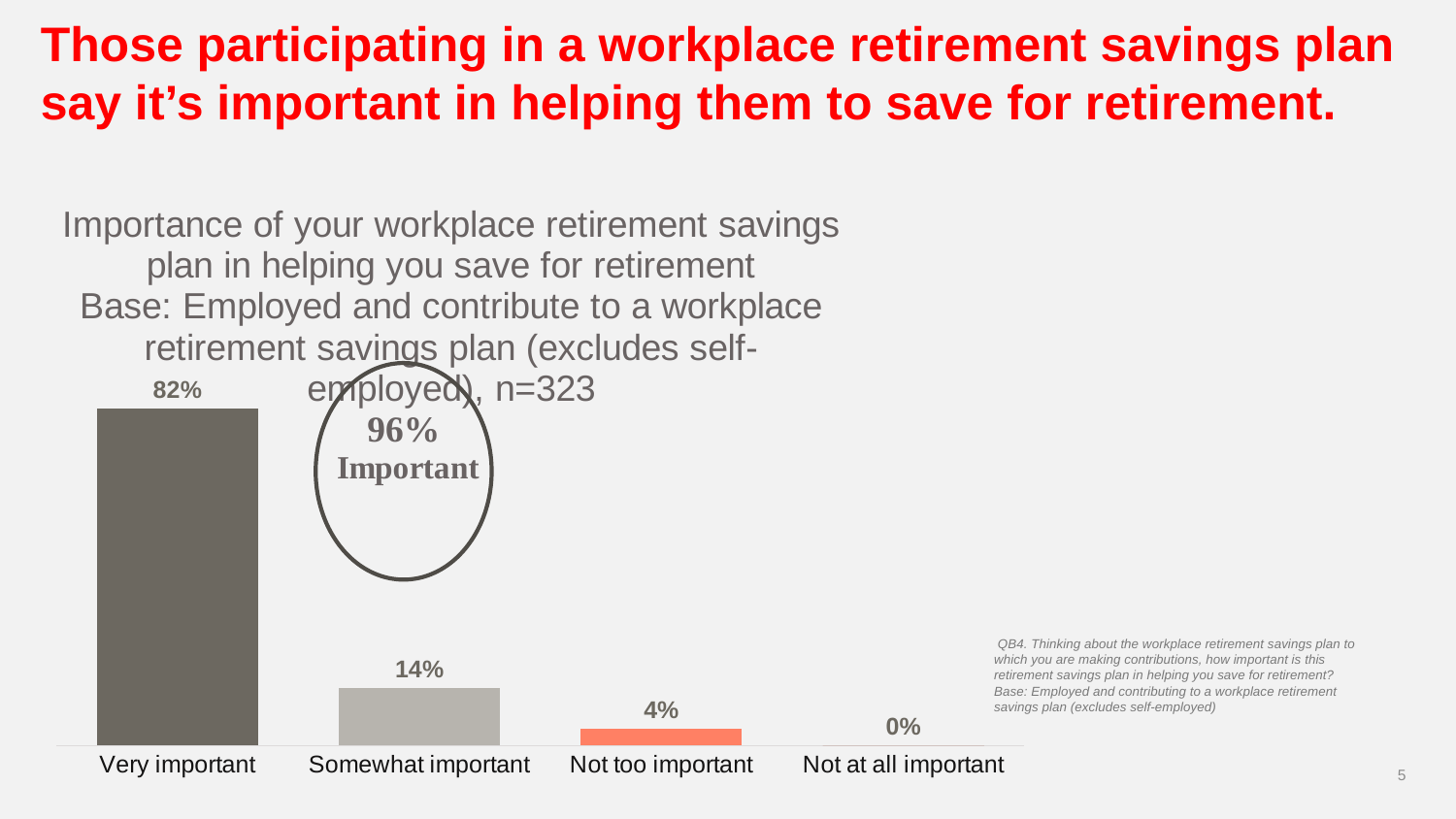
Which category has the lowest value? Not at all important How many categories are shown on the chart? 4 Which category has the highest value? Very important What percentage of respondents said their workplace retirement savings plan is very important? 82% What percentage of respondents said their workplace retirement savings plan is somewhat important? 14% What percentage of respondents said their workplace retirement savings plan is not too important? 4% Which is larger, the value for Somewhat important or the value for Not too important? Somewhat important What is the difference between the Very important and Somewhat important values? 68% Do the values rise or fall moving from left to right across the categories? Fall What percentage of respondents said their workplace retirement savings plan is not at all important? 0% What kind of chart is shown on the slide? Bar chart What percentage is shown in the circled callout on the chart? 96% Important